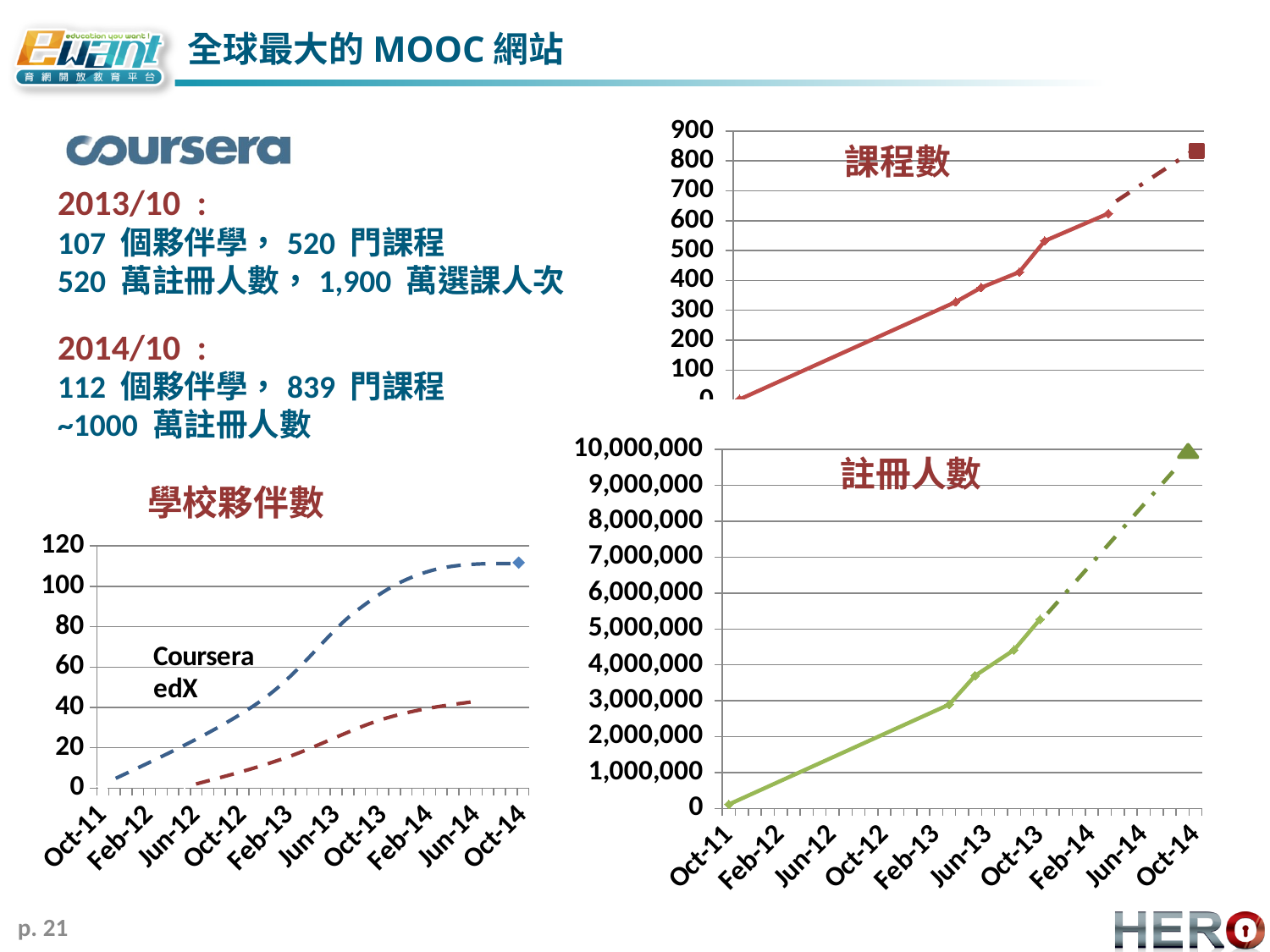
In the 註冊人數 chart, do the values rise or fall along the x axis? rise In the 註冊人數 chart, is the value at Oct-14 greater or less than 9,000,000? greater What kind of chart is the 課程數 chart at the top right? line chart How many x-axis labels are shown on the 註冊人數 chart? 10 How many series are plotted in the 學校夥伴數 chart? 2 In the 學校夥伴數 chart, is the Coursera value at Oct-14 greater or less than 100? greater In the 課程數 chart, do the values rise or fall from Oct-11 to Oct-14? rise In the 課程數 chart, is the value at Oct-14 greater or less than 800? greater In the 學校夥伴數 chart, which series is higher at Jun-14, Coursera or edX? Coursera